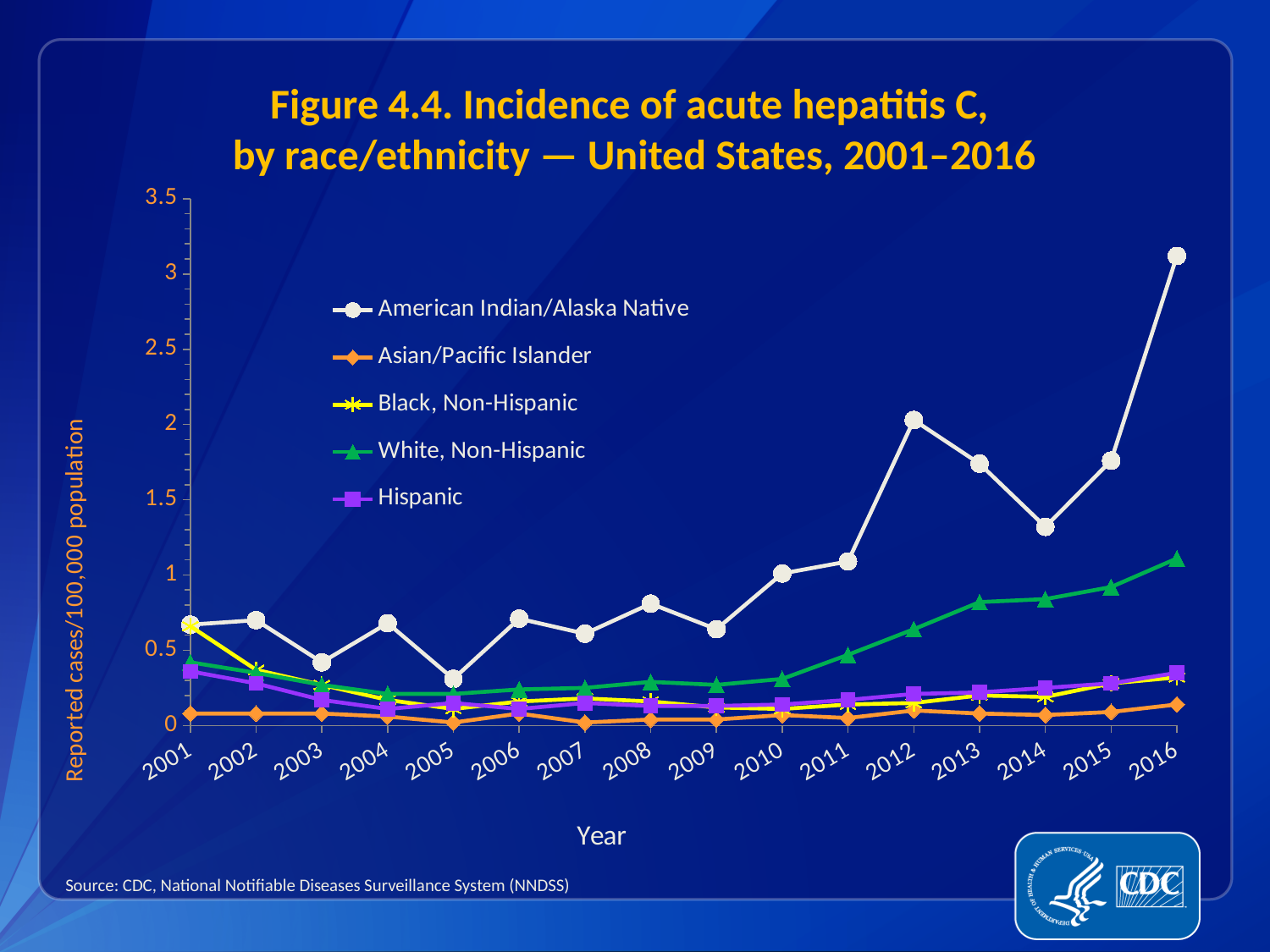
Is the value for American Indian/Alaska Native in 2016 greater or less than 2.5? greater How many years are plotted along the x axis? 16 In 2016, which is larger: the value for White, Non-Hispanic or the value for Hispanic? White, Non-Hispanic What kind of chart is shown on the slide? line chart Is the value for Asian/Pacific Islander in 2005 greater or less than 0.5? less Which race/ethnicity group has the highest incidence in 2016? American Indian/Alaska Native Which race/ethnicity group has the lowest incidence in 2016? Asian/Pacific Islander Does the White, Non-Hispanic series rise or fall from 2010 to 2016? rise How many series does the legend list? 5 Is the value for American Indian/Alaska Native in 2012 greater or less than 1.5? greater In which year does the American Indian/Alaska Native series reach its highest value? 2016